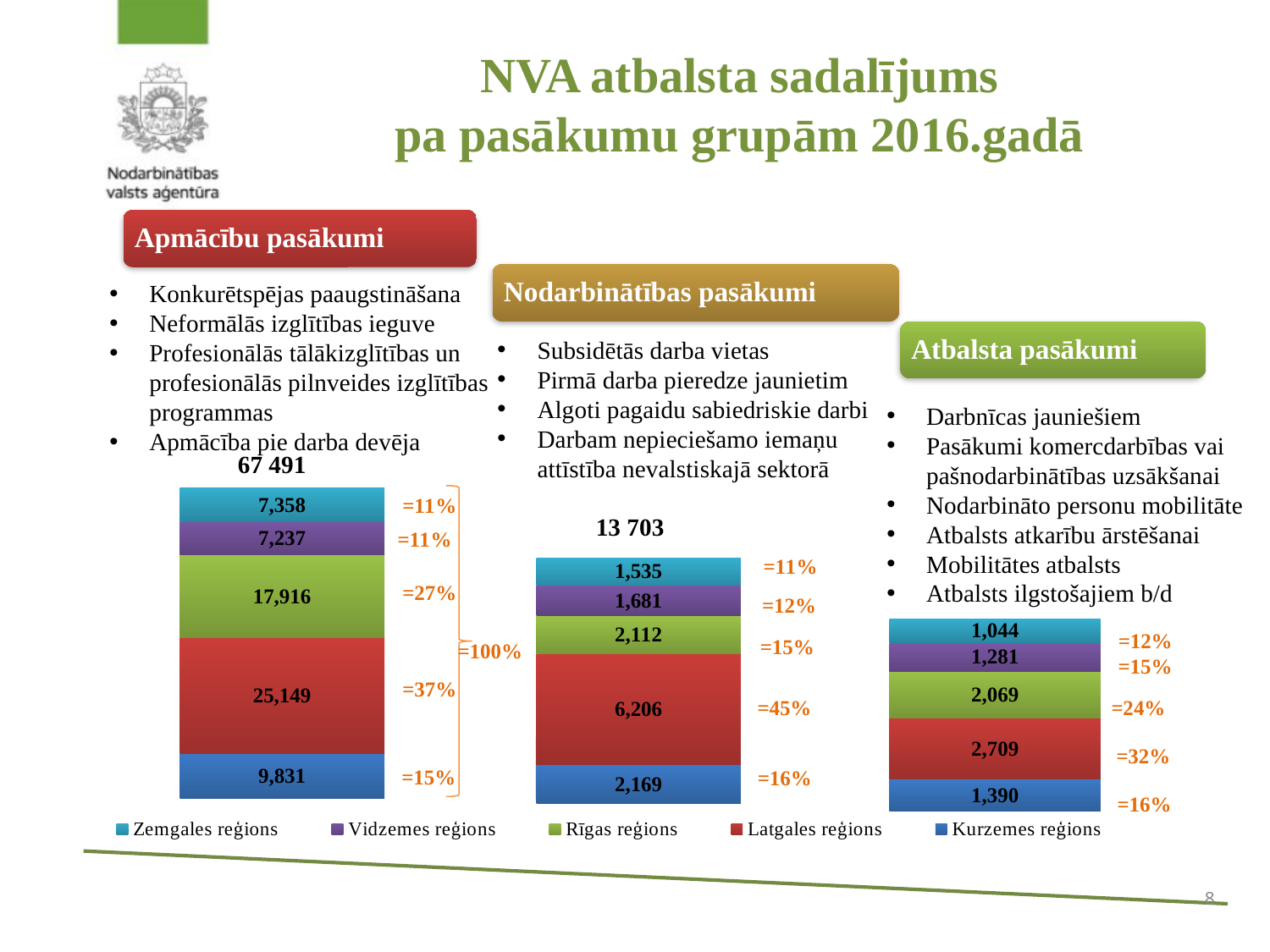
What type of chart is used for the Atbalsta pasākumi data (right)? Stacked bar chart In the Apmācību pasākumi chart (left), which is larger: Zemgales reģions or Vidzemes reģions? Zemgales reģions How many regions does the legend list? 5 In the Atbalsta pasākumi chart (right), what is the value for Kurzemes reģions? 1,390 In the Apmācību pasākumi chart (left), which region has the highest value? Latgales reģions What is the total shown above the Apmācību pasākumi chart (left)? 67 491 In the Apmācību pasākumi chart (left), what percentage share does Latgales reģions have? =37% In the Nodarbinātības pasākumi chart (middle), which region has the lowest value? Zemgales reģions In the Apmācību pasākumi chart (left), what is the value for Latgales reģions? 25,149 What is the total shown above the Nodarbinātības pasākumi chart (middle)? 13 703 In the Atbalsta pasākumi chart (right), what is the difference between Latgales reģions and Rīgas reģions? 640 In the Nodarbinātības pasākumi chart (middle), what is the value for Rīgas reģions? 2,112